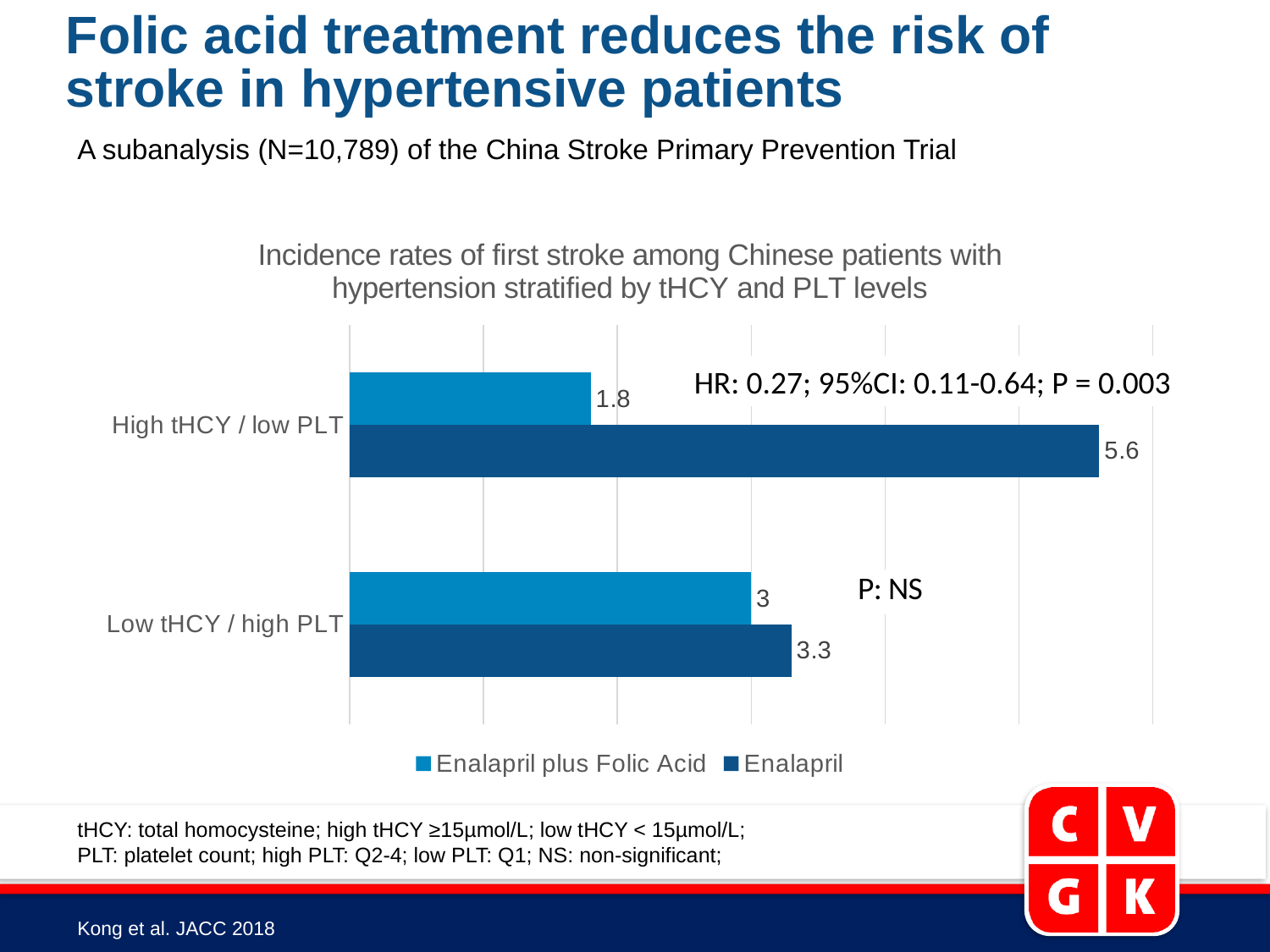
What hazard ratio is annotated next to the High tHCY / low PLT bars? 0.27 Which bar has the lowest value on the chart? Enalapril plus Folic Acid, High tHCY / low PLT What is the incidence rate for Enalapril plus Folic Acid in the Low tHCY / high PLT group? 3 What is the difference between the Enalapril and Enalapril plus Folic Acid values in the High tHCY / low PLT group? 3.8 How many patient groups (categories) are shown on the chart? 2 What kind of chart is shown on the slide? Bar chart How many series does the legend list? 2 What is the incidence rate for Enalapril in the High tHCY / low PLT group? 5.6 What is the incidence rate for Enalapril in the Low tHCY / high PLT group? 3.3 What is the incidence rate for Enalapril plus Folic Acid in the High tHCY / low PLT group? 1.8 In the Low tHCY / high PLT group, which is larger: Enalapril or Enalapril plus Folic Acid? Enalapril Which bar has the highest value on the chart? Enalapril, High tHCY / low PLT